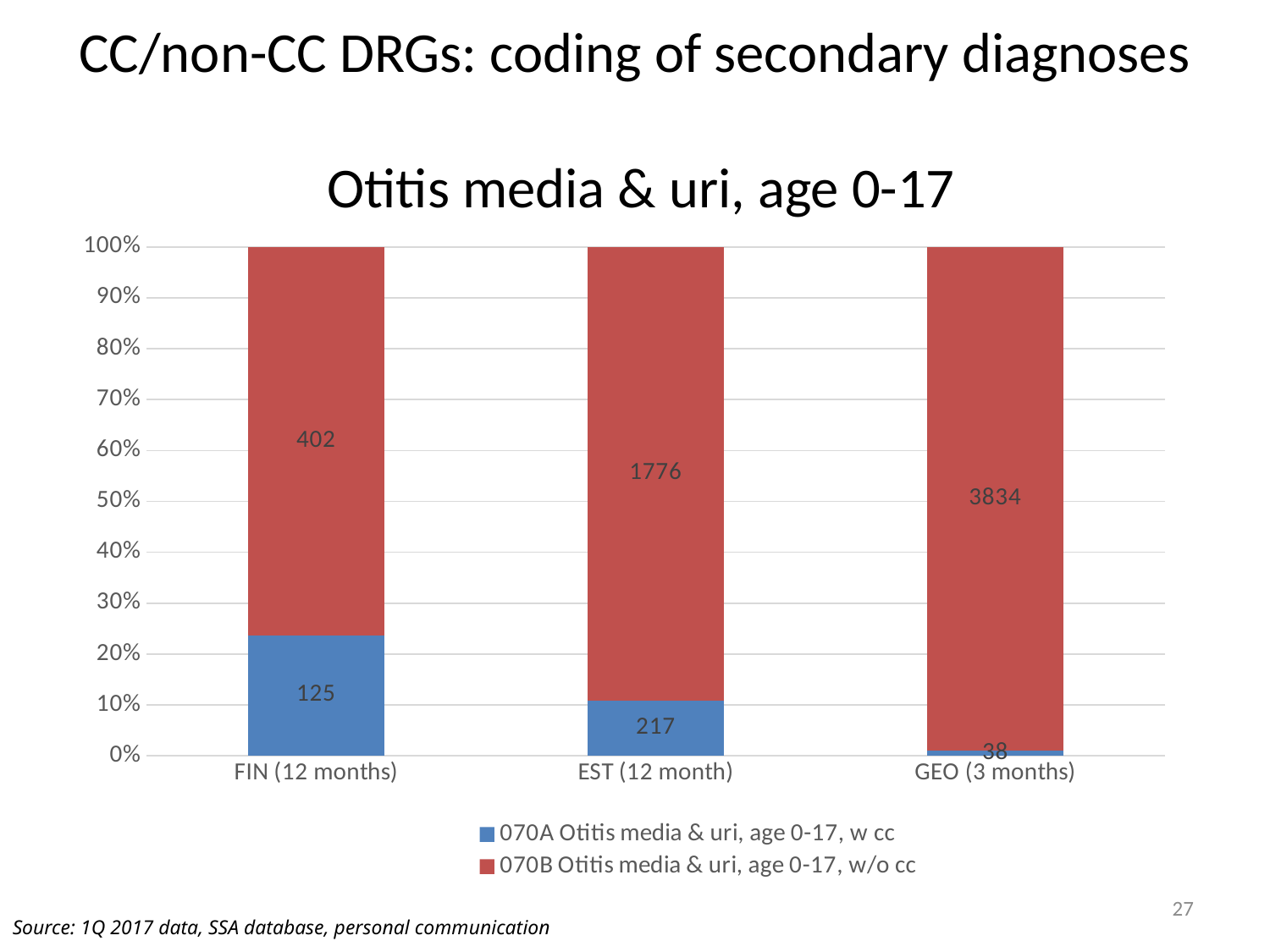
What is the value for 070A Otitis media & uri, age 0-17, w cc for GEO (3 months)? 38 Which category has the highest value for 070B Otitis media & uri, age 0-17, w/o cc? GEO (3 months) What is the value for 070A Otitis media & uri, age 0-17, w cc for FIN (12 months)? 125 What is the value for 070B Otitis media & uri, age 0-17, w/o cc for EST (12 month)? 1776 Is the share of the FIN (12 months) bar taken by 070A Otitis media & uri, age 0-17, w cc greater or less than 20%? greater What is the difference between the w/o cc value and the w cc value for FIN (12 months)? 277 Which is larger: the w cc value for EST (12 month) or the w cc value for FIN (12 months)? EST (12 month) What is the value for 070B Otitis media & uri, age 0-17, w/o cc for GEO (3 months)? 3834 What is the total of the two values in the EST (12 month) bar? 1993 How many categories are shown on the x axis? 3 Which category has the lowest value for 070A Otitis media & uri, age 0-17, w cc? GEO (3 months) How many series does the legend list? 2